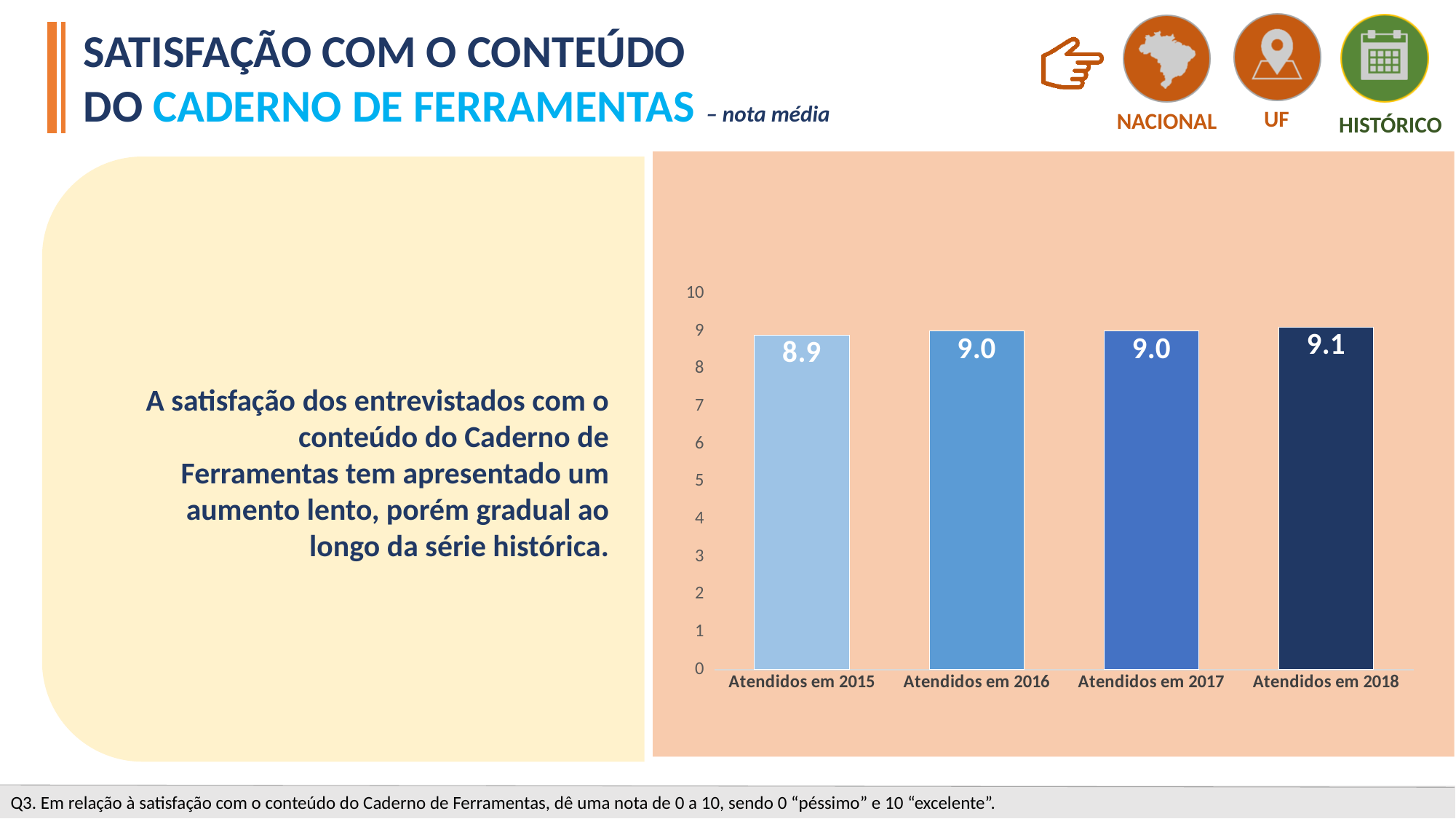
What is the difference between the values for Atendidos em 2018 and Atendidos em 2015? 0.2 Is the value for Atendidos em 2015 greater or less than 8? greater What is the maximum value shown on the vertical axis? 10 What kind of chart is shown on the slide? bar chart What is the value for Atendidos em 2015? 8.9 How many categories are shown on the x axis? 4 Which category has the lowest value? Atendidos em 2015 What is the value for Atendidos em 2016? 9.0 Do the values rise or fall from Atendidos em 2015 to Atendidos em 2018? rise Which is larger, the value for Atendidos em 2017 or Atendidos em 2018? Atendidos em 2018 What is the value for Atendidos em 2018? 9.1 Which category has the highest value? Atendidos em 2018